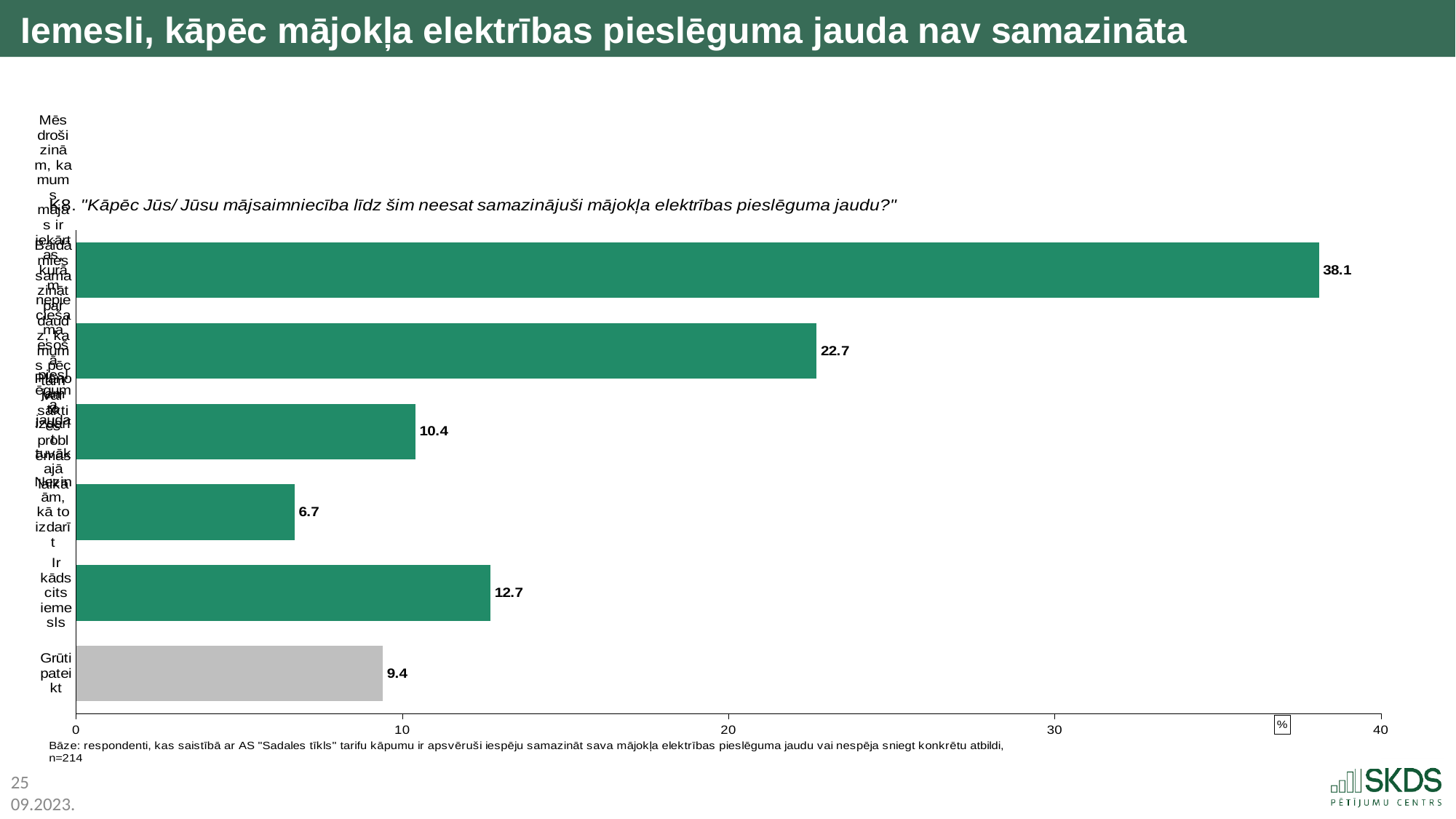
What colour is the bar for "Grūti pateikt"? grey What is the highest value shown in the chart? 38.1 Which is larger, the value for "Ir kāds cits iemesls" or the value for "Grūti pateikt"? Ir kāds cits iemesls How many bars does the chart contain? 6 What is the value for "Grūti pateikt"? 9.4 What is the difference between the values for "Ir kāds cits iemesls" and "Grūti pateikt"? 3.3 What is the lowest value shown in the chart? 6.7 What is the value for "Ir kāds cits iemesls"? 12.7 What kind of chart is shown on the slide? bar chart Is the value of the top bar greater or less than 30? greater What is the difference between the top bar (38.1) and the second bar from the top (22.7)? 15.4 What is the maximum value shown on the horizontal axis? 40